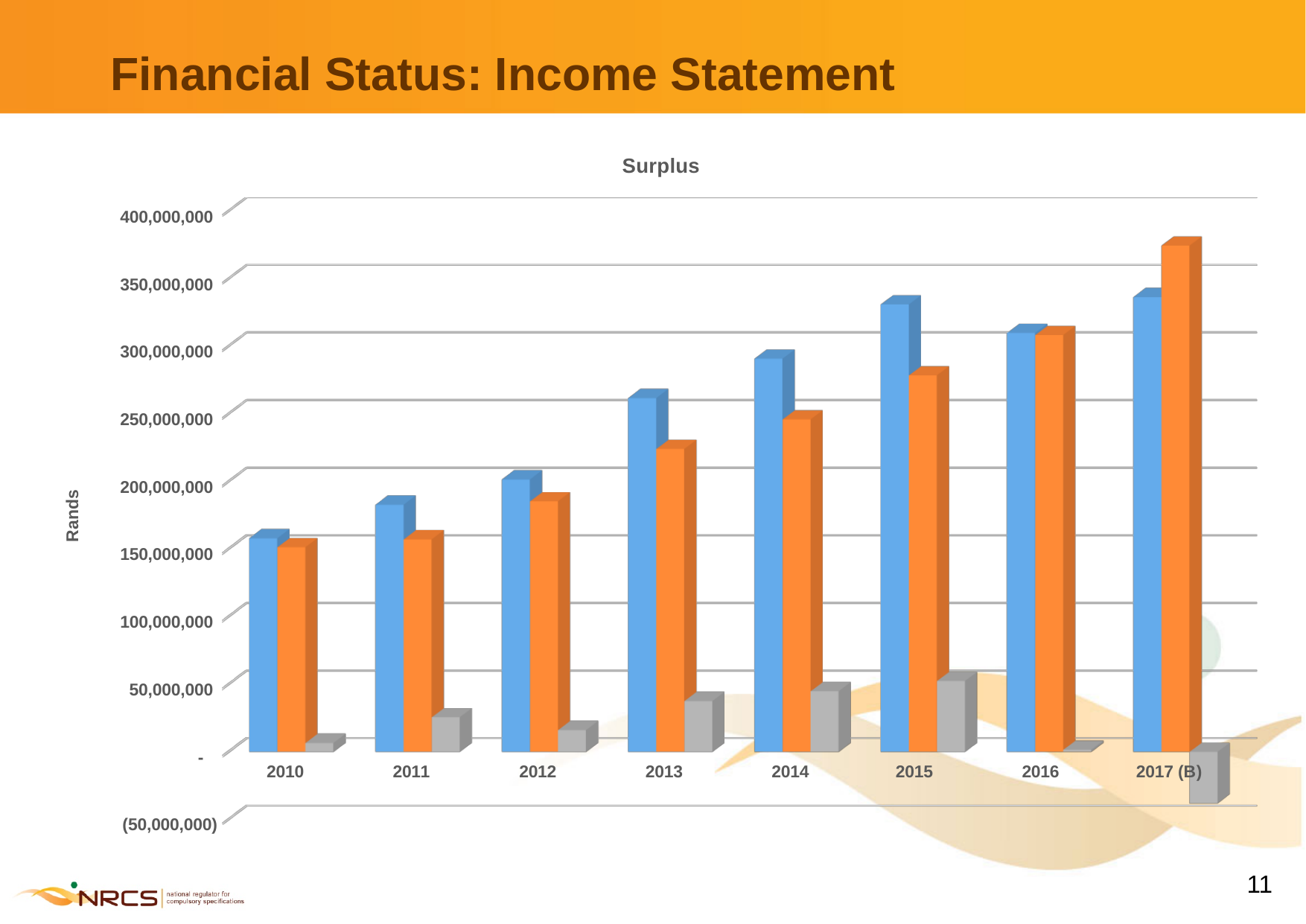
In which year is the grey bar the lowest? 2017 (B) What kind of chart is shown on the slide? bar chart How many year categories are shown on the x axis of the chart? 8 Do the orange bars generally rise or fall from 2010 to 2017 (B)? rise Is the value of the orange bar for 2017 (B) greater or less than 350,000,000? greater For 2014, which is larger, the blue bar or the orange bar? the blue bar What is the title of the chart? Surplus Is the value of the orange bar for 2013 greater or less than 250,000,000? less In which year is the blue bar the lowest? 2010 How many bars are plotted for each year category? 3 What is the label on the vertical axis of the chart? Rands In which year is the orange bar the highest? 2017 (B)